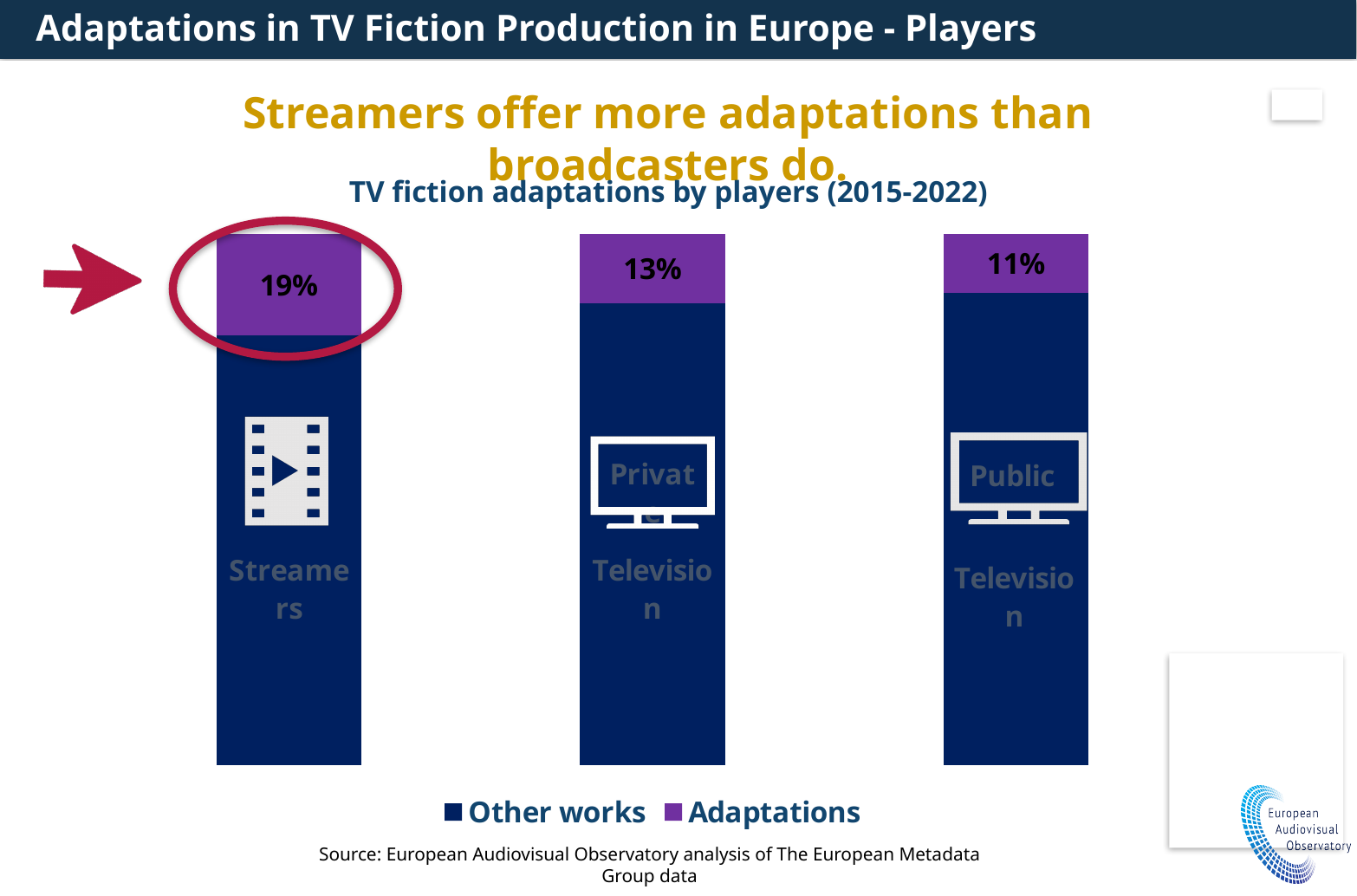
What share of TV fiction works by Streamers are adaptations? 19% What is the title of the chart? TV fiction adaptations by players (2015-2022) Which player has the lowest share of adaptations? Public Television How many series does the legend list? 2 What kind of chart is shown on the slide? Stacked bar chart What share of TV fiction works by Public Television are adaptations? 11% Which player has the highest share of adaptations? Streamers How many players (categories) are shown in the chart? 3 Which has a larger share of adaptations, Streamers or Public Television? Streamers What is the difference between the adaptations share for Streamers and for Private Television? 6 percentage points What share of TV fiction works by Private Television are adaptations? 13% What is the difference between the adaptations share for Private Television and for Public Television? 2 percentage points